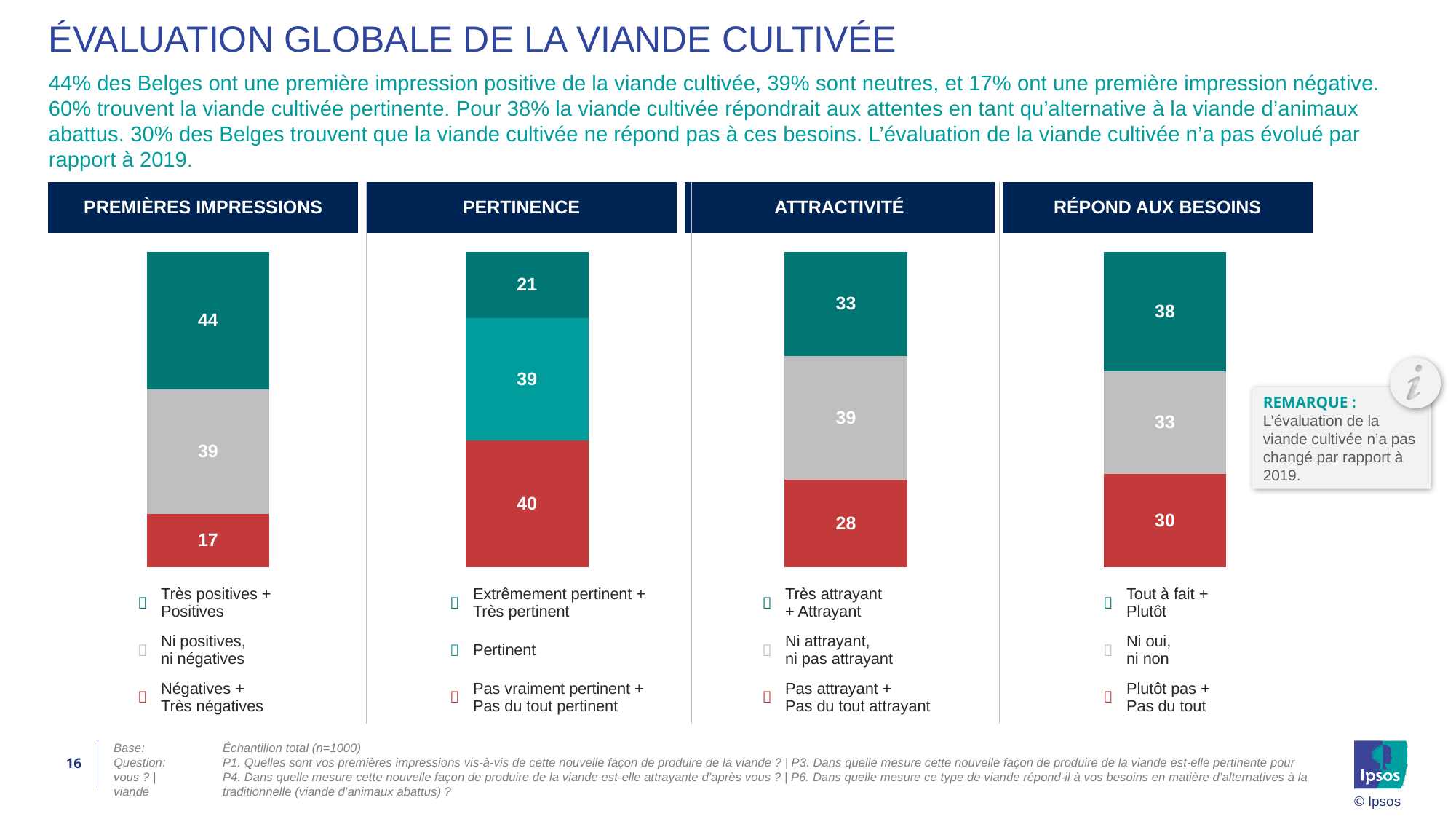
In the PERTINENCE chart, what is the value for 'Pas vraiment pertinent + Pas du tout pertinent'? 40 What kind of chart is used in the ATTRACTIVITÉ panel? Stacked bar chart In the PREMIÈRES IMPRESSIONS chart, what is the value for 'Très positives + Positives'? 44 How many segments does the stacked bar in the PERTINENCE chart have? 3 In the RÉPOND AUX BESOINS chart, what is the value for 'Tout à fait + Plutôt'? 38 In the PERTINENCE chart, what is the value for 'Extrêmement pertinent + Très pertinent'? 21 In the ATTRACTIVITÉ chart, what is the value for 'Ni attrayant, ni pas attrayant'? 39 In the RÉPOND AUX BESOINS chart, what is the total of the stacked bar? 101 In the PREMIÈRES IMPRESSIONS chart, which segment has the lowest value? Négatives + Très négatives In the PERTINENCE chart, which segment has the highest value? Pas vraiment pertinent + Pas du tout pertinent In the PREMIÈRES IMPRESSIONS chart, what is the difference between 'Très positives + Positives' and 'Négatives + Très négatives'? 27 In the ATTRACTIVITÉ chart, which is larger: 'Très attrayant + Attrayant' or 'Pas attrayant + Pas du tout attrayant'? Très attrayant + Attrayant